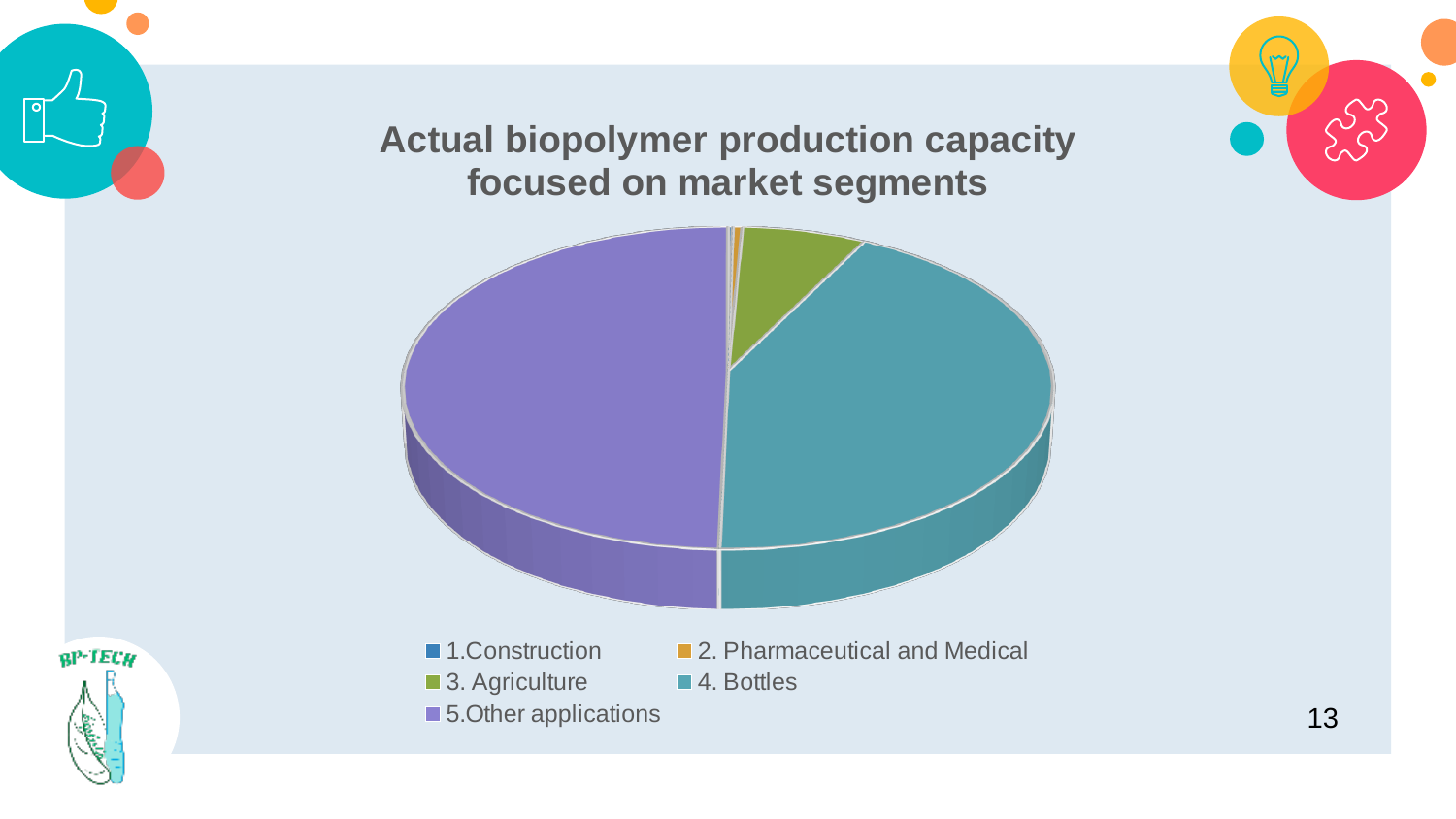
What kind of chart is shown on the slide? pie chart How many categories does the pie chart's legend list? 5 Which slice is larger, 3. Agriculture or 1.Construction? 3. Agriculture Which category has the largest slice of the pie? 5.Other applications Which category is shown in purple on the pie chart? 5.Other applications Which slice is larger, 5.Other applications or 4. Bottles? 5.Other applications Which category is the second-largest slice of the pie? 4. Bottles What is the title of the chart? Actual biopolymer production capacity focused on market segments Which slice is larger, 4. Bottles or 3. Agriculture? 4. Bottles